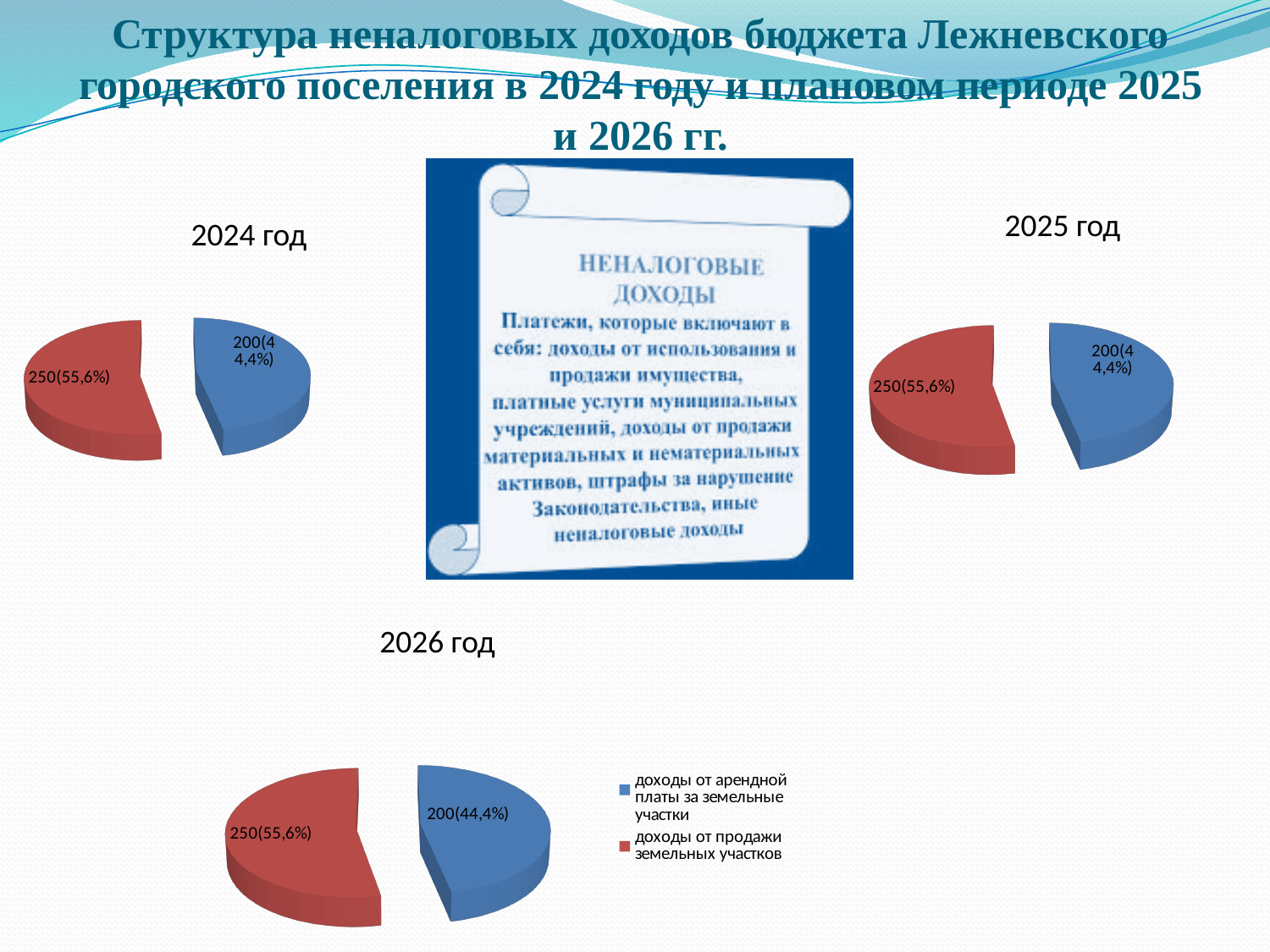
On the "2026 год" chart, which category is the smallest? доходы от арендной платы за земельные участки On the "2026 год" chart, which is larger: доходы от арендной платы за земельные участки or доходы от продажи земельных участков? доходы от продажи земельных участков On the "2024 год" chart, what value is shown for the blue slice (доходы от арендной платы за земельные участки)? 200(44,4%) On the "2025 год" chart, what is the difference between the value for доходы от продажи земельных участков and the value for доходы от арендной платы за земельные участки? 50 On the "2026 год" chart, what share of the pie is доходы от продажи земельных участков? 55,6% On the "2024 год" chart, what value is shown for the red slice (доходы от продажи земельных участков)? 250(55,6%) On the "2025 год" chart, what share of the pie is доходы от арендной платы за земельные участки? 44,4% What kind of chart is the "2024 год" chart? pie chart On the "2026 год" chart, what value is shown for доходы от арендной платы за земельные участки? 200(44,4%) How many categories does the legend on the slide list? 2 On the "2024 год" chart, which category is the largest? доходы от продажи земельных участков On the "2025 год" chart, what value is shown for доходы от продажи земельных участков? 250(55,6%)